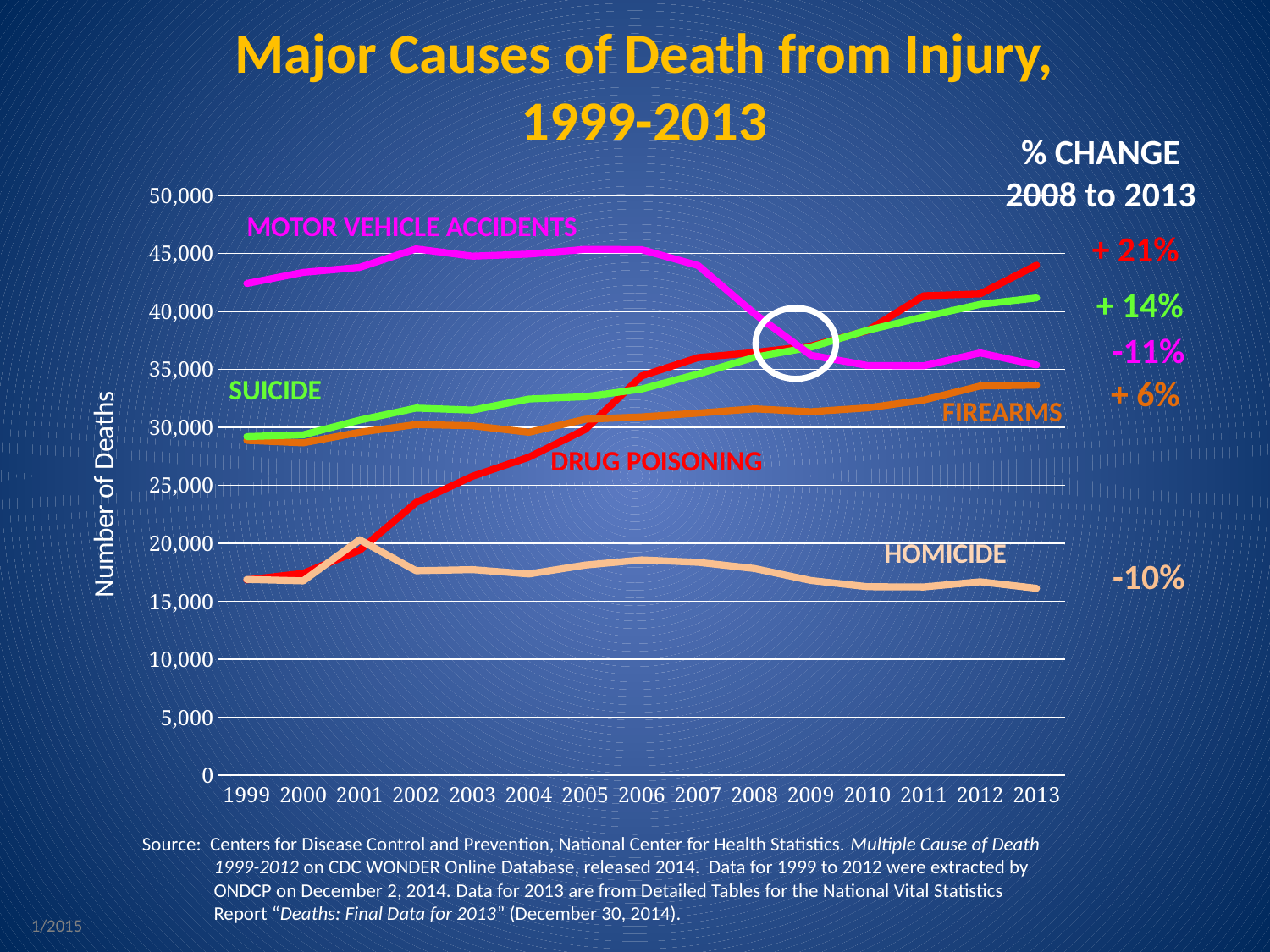
How many years are shown along the x axis of the chart? 15 Is the number of deaths from Drug Poisoning in 1999 greater or less than 20,000? less What is the % change from 2008 to 2013 shown for Homicide? -10% How many causes of death are plotted as lines on the chart? 5 What is the % change from 2008 to 2013 shown for Drug Poisoning? + 21% What kind of chart is shown on the slide? Line chart Is the number of deaths from Motor Vehicle Accidents in 1999 greater or less than 40,000? greater Which cause of death had the highest number of deaths in 1999? Motor Vehicle Accidents Does the Drug Poisoning line generally rise or fall from 1999 to 2013? Rise What is the % change from 2008 to 2013 shown for Suicide? + 14% In 2013, which cause had more deaths: Drug Poisoning or Motor Vehicle Accidents? Drug Poisoning Which cause of death had the lowest number of deaths in 2013? Homicide